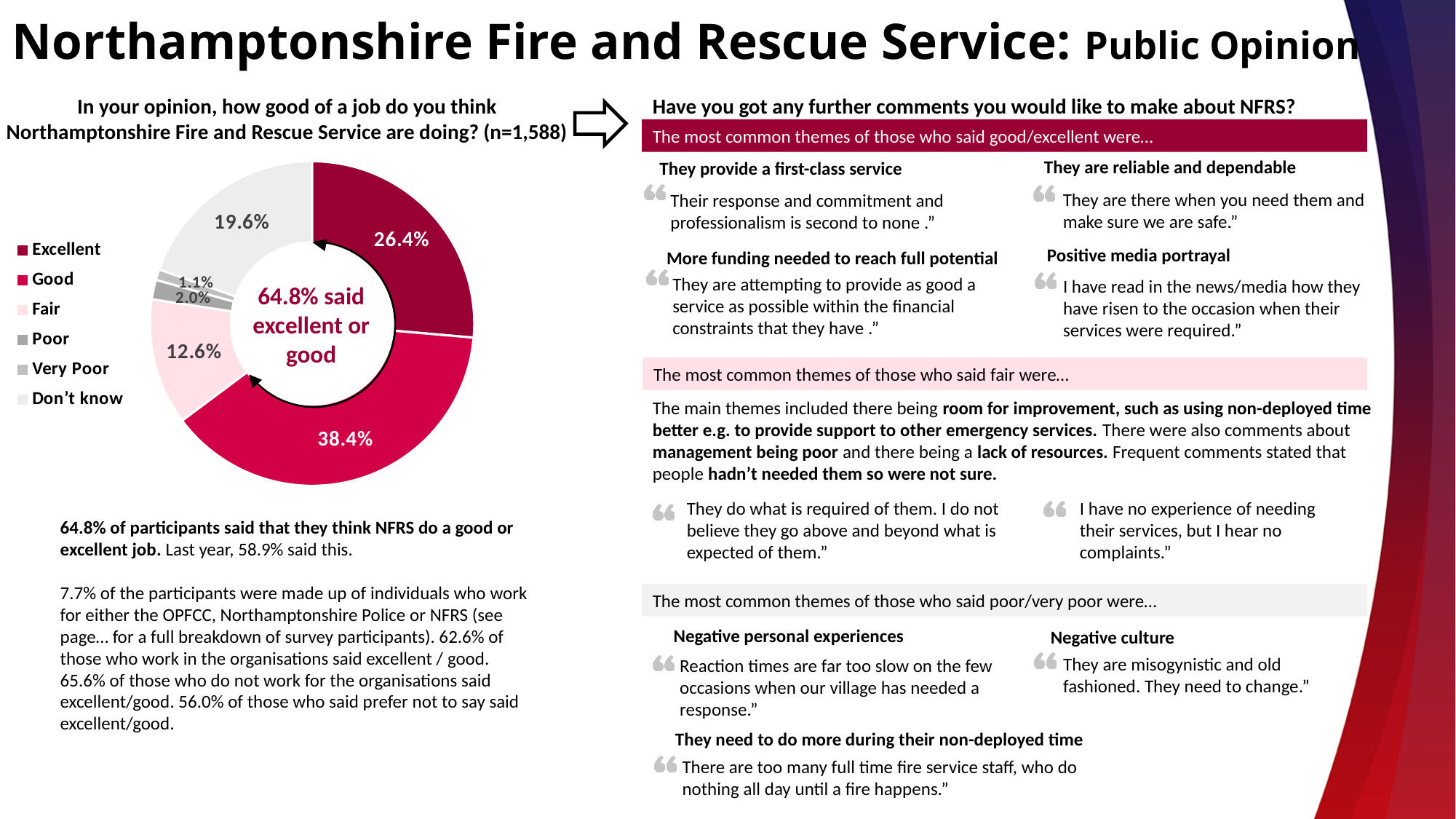
How many response categories does the chart's legend list? 6 What share of respondents answered 'Don't know'? 19.6% What percentage of respondents rated the service as 'Fair'? 12.6% Which response category has the largest share of the doughnut chart? Good What percentage of respondents rated the service as 'Excellent'? 26.4% What type of chart is used to show how good a job respondents think NFRS are doing? Doughnut (pie) chart What percentage of respondents said Northamptonshire Fire and Rescue Service are doing a 'Good' job? 38.4% What is the difference in percentage points between the 'Good' and 'Excellent' shares? 12.0 percentage points Which response category has the smallest share of the doughnut chart? Very Poor Which is larger: the share for 'Fair' or the share for 'Don't know'? Don't know What percentage of respondents rated the service as 'Very Poor'? 1.1% What combined percentage is shown in the centre of the doughnut chart for 'excellent or good'? 64.8%